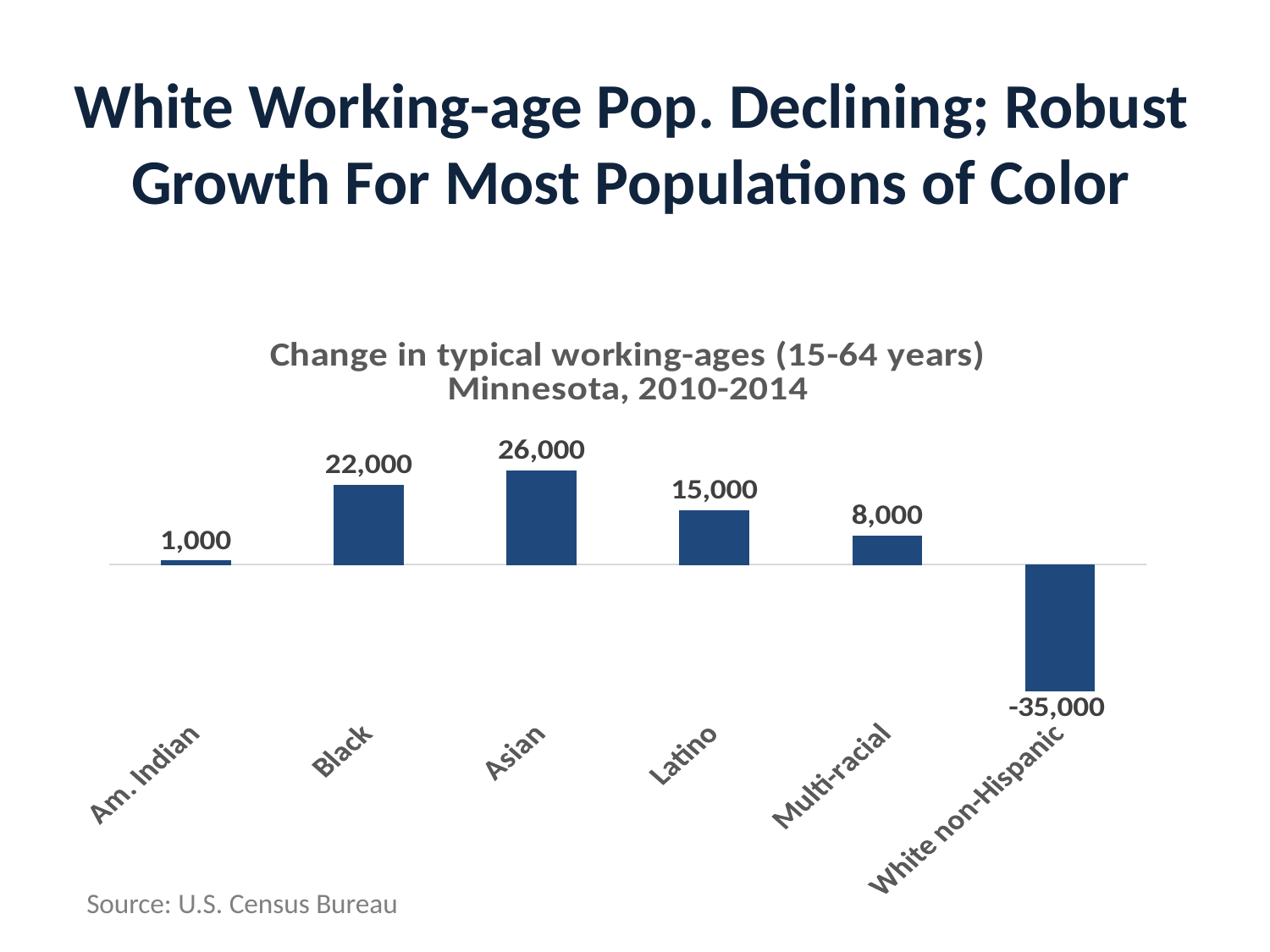
What is the value for Am. Indian? 1,000 What kind of chart is this? Bar chart Which category has the lowest value? White non-Hispanic What source is cited for the chart? U.S. Census Bureau Which is larger, the value for Black or the value for Asian? Asian What is the value for Asian? 26,000 What is the value for Multi-racial? 8,000 What is the value for White non-Hispanic? -35,000 What is the difference between the values for Black and Latino? 7,000 What is the title of the chart? Change in typical working-ages (15-64 years) Minnesota, 2010-2014 Which category has the highest value? Asian How many categories are shown on the x axis? 6